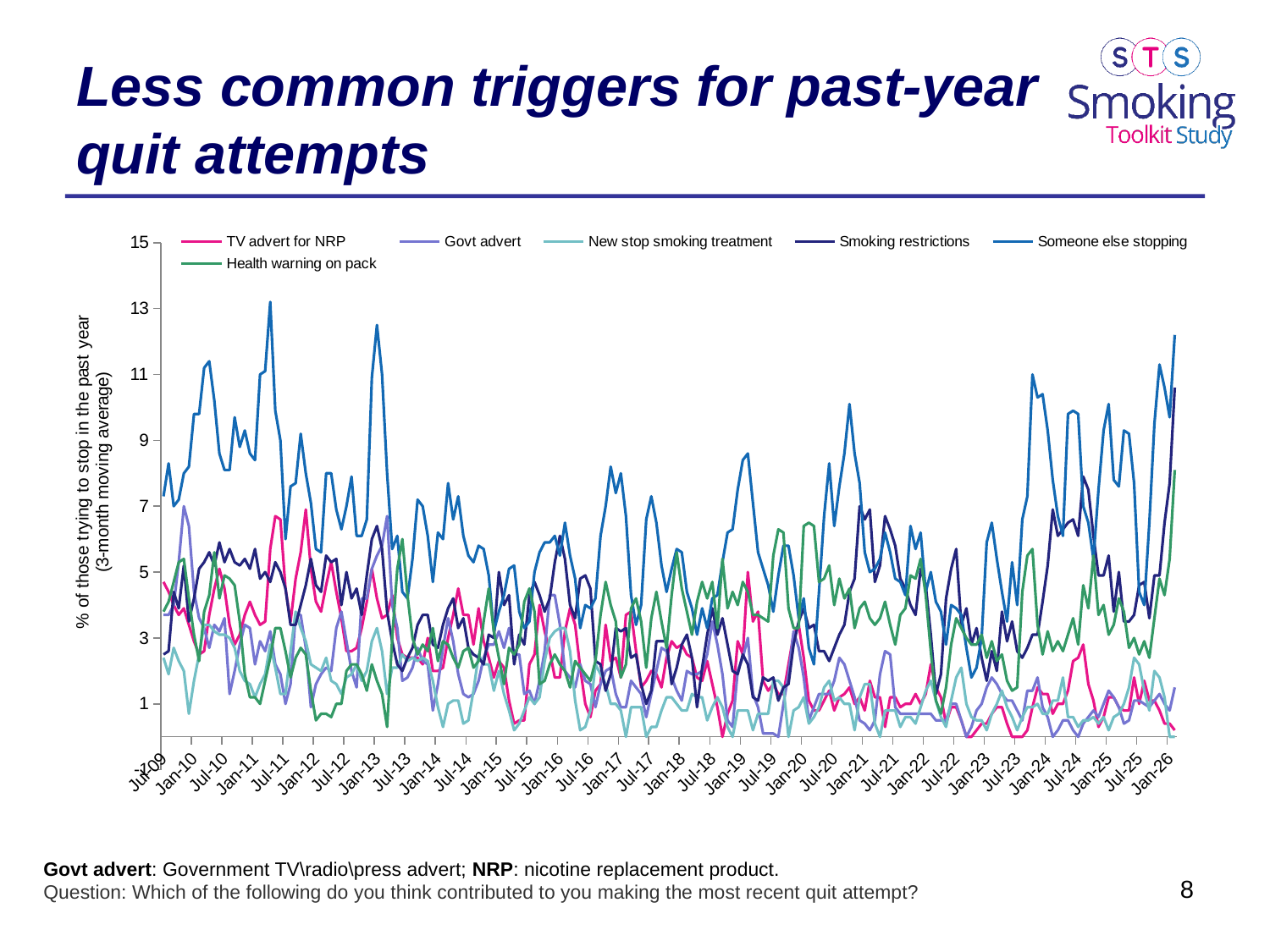
At Jan-26, which is higher: Someone else stopping or TV advert for NRP? Someone else stopping Which series has the highest values across most of the period shown? Someone else stopping Is the value for New stop smoking treatment at Jan-26 greater or less than 3? less Does the TV advert for NRP series generally rise or fall from Jul-09 to Jan-26? fall What kind of chart is shown on the slide? line chart Is the peak value for Someone else stopping around Jul-11 greater or less than 11? greater What is the label on the y axis of the chart? % of those trying to stop in the past year (3-month moving average) Around Jan-13, which is higher: Someone else stopping or Govt advert? Someone else stopping How many series does the legend list? 6